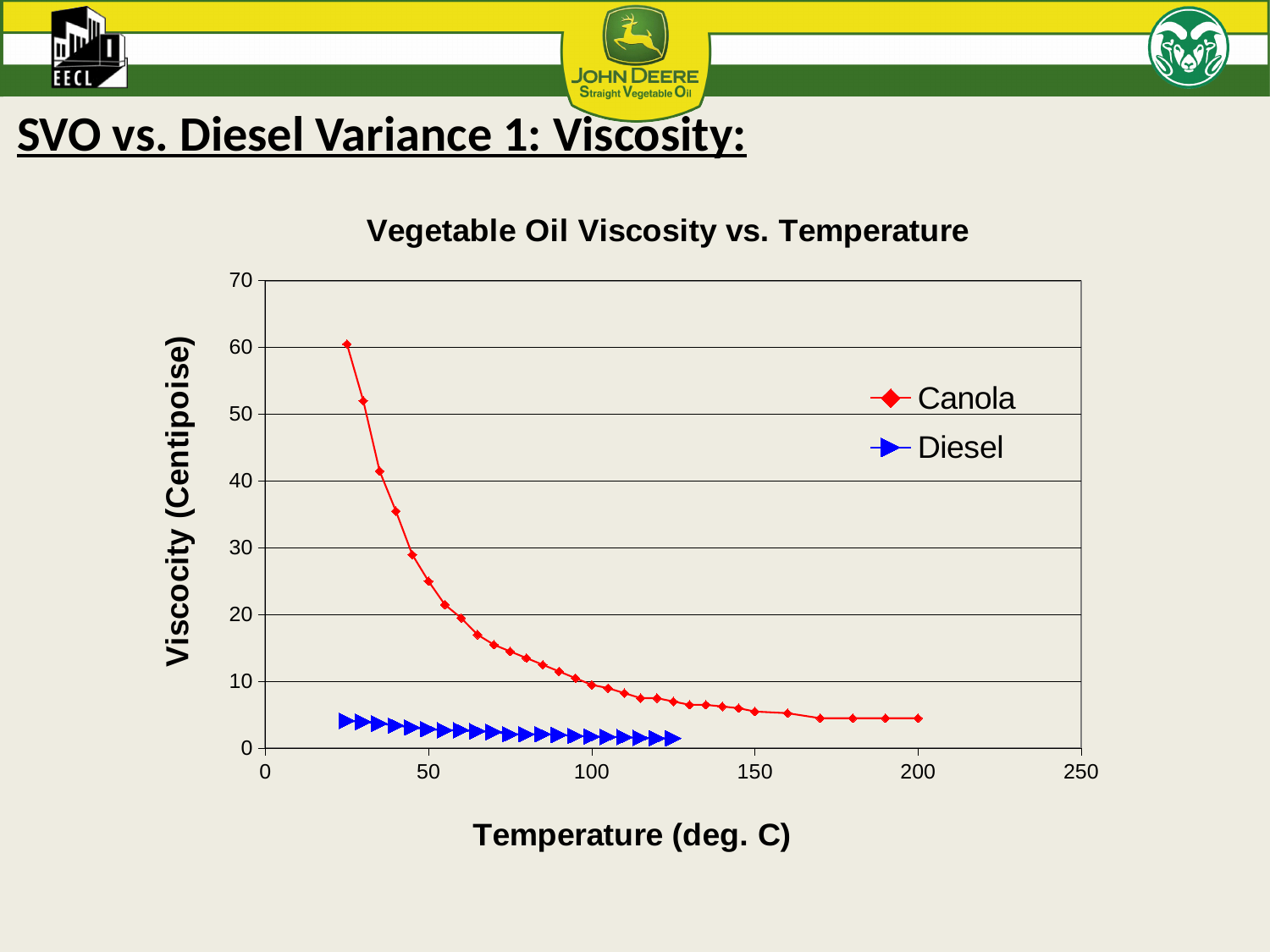
Is the Diesel viscosity at 50 deg. C greater or less than 10 centipoise? less At 100 deg. C, which series has the higher viscosity, Canola or Diesel? Canola Is the Canola viscosity at 50 deg. C greater or less than 20 centipoise? greater What kind of chart is shown on the slide? line chart How many series does the legend list? 2 Which series has the lower viscosity across the plotted temperature range? Diesel Is the Canola viscosity at 200 deg. C greater or less than 10 centipoise? less What are the two series named in the legend? Canola and Diesel Does the Canola viscosity rise or fall as temperature increases along the x axis? fall What is the title of the chart? Vegetable Oil Viscosity vs. Temperature